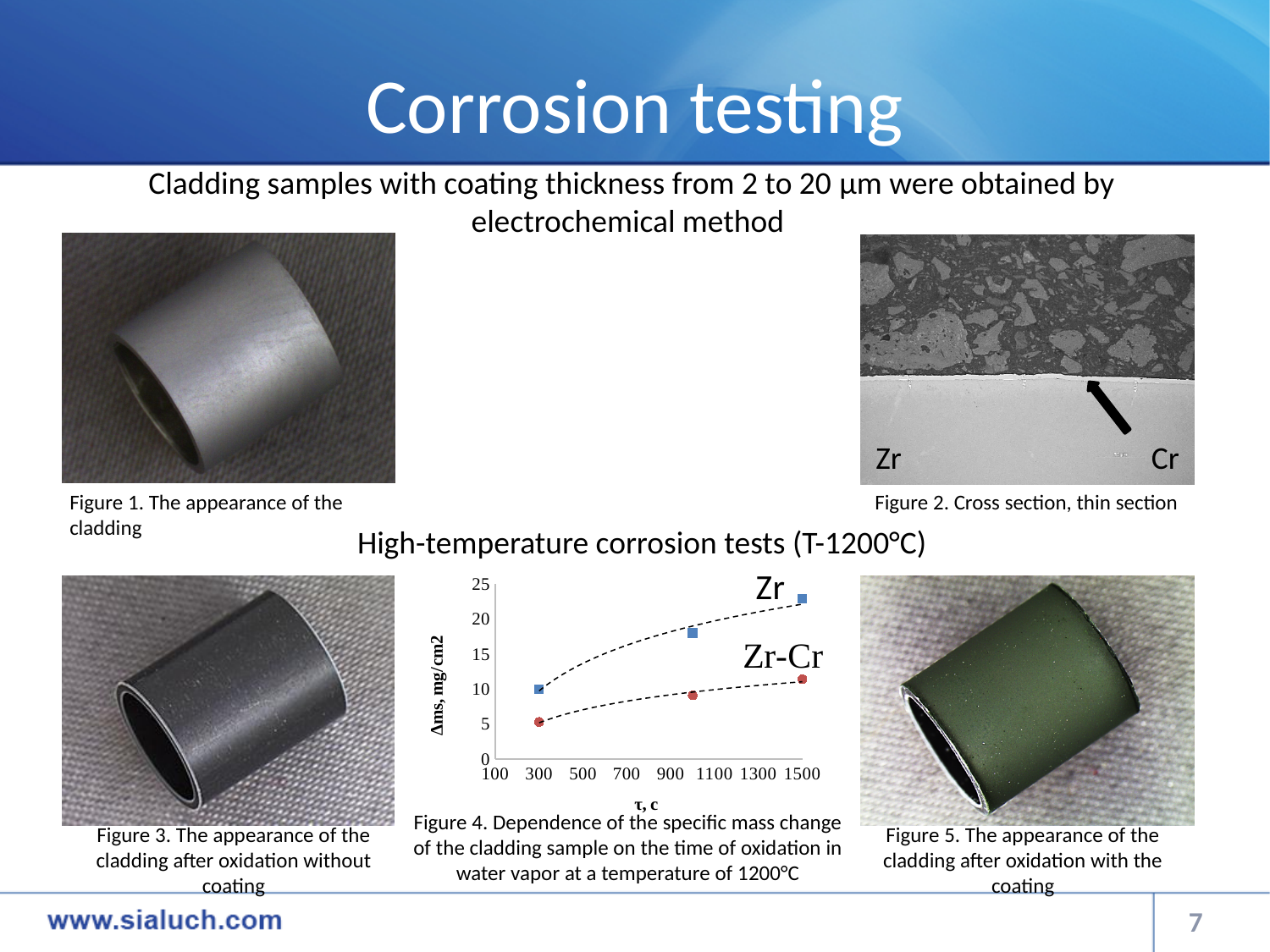
In Figure 4, which series shows the larger mass change at 1500 c, Zr or Zr-Cr? Zr What is the label of the x axis in Figure 4? τ, c In Figure 4, is the value for Zr at 1500 c greater or less than 20? greater What is the label of the y axis in Figure 4? Δms, mg/cm2 How many series are plotted in Figure 4? 2 What kind of chart is Figure 4? scatter chart In Figure 4, does the specific mass change for Zr rise or fall as the oxidation time increases? rises How many data points are plotted for the Zr-Cr series in Figure 4? 3 How many data points are plotted for the Zr series in Figure 4? 3 In Figure 4, is the value for Zr-Cr at 1500 c greater or less than 15? less In Figure 4, which series has the highest specific mass change overall? Zr In Figure 4, is the value for Zr-Cr at 300 c greater or less than 10? less